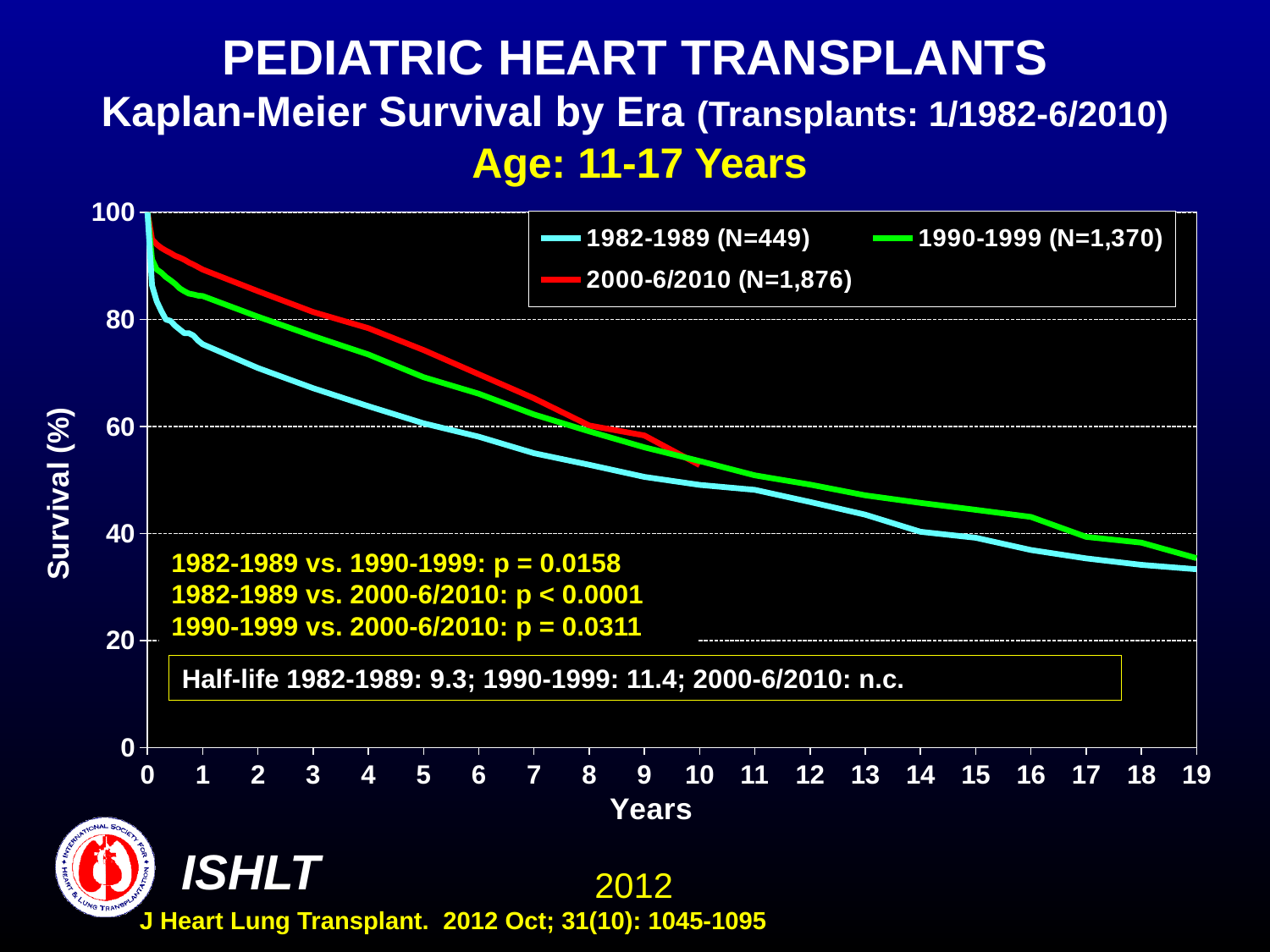
Is the survival value for the 2000-6/2010 era at 1 year greater or less than 80? greater What kind of chart is shown on the slide? line chart What is the N for the 1990-1999 era shown in the legend? 1,370 How many series does the legend list? 3 What is the N for the 2000-6/2010 era shown in the legend? 1,876 At 5 years, which era has higher survival: 1982-1989 or 2000-6/2010? 2000-6/2010 At 15 years, which era has higher survival: 1982-1989 or 1990-1999? 1990-1999 Is the survival value for the 1990-1999 era at 19 years greater or less than 40? less Do the survival curves rise or fall as years increase? fall Is the survival value for the 2000-6/2010 era at 5 years greater or less than 60? greater Which era has the lowest survival at 5 years? 1982-1989